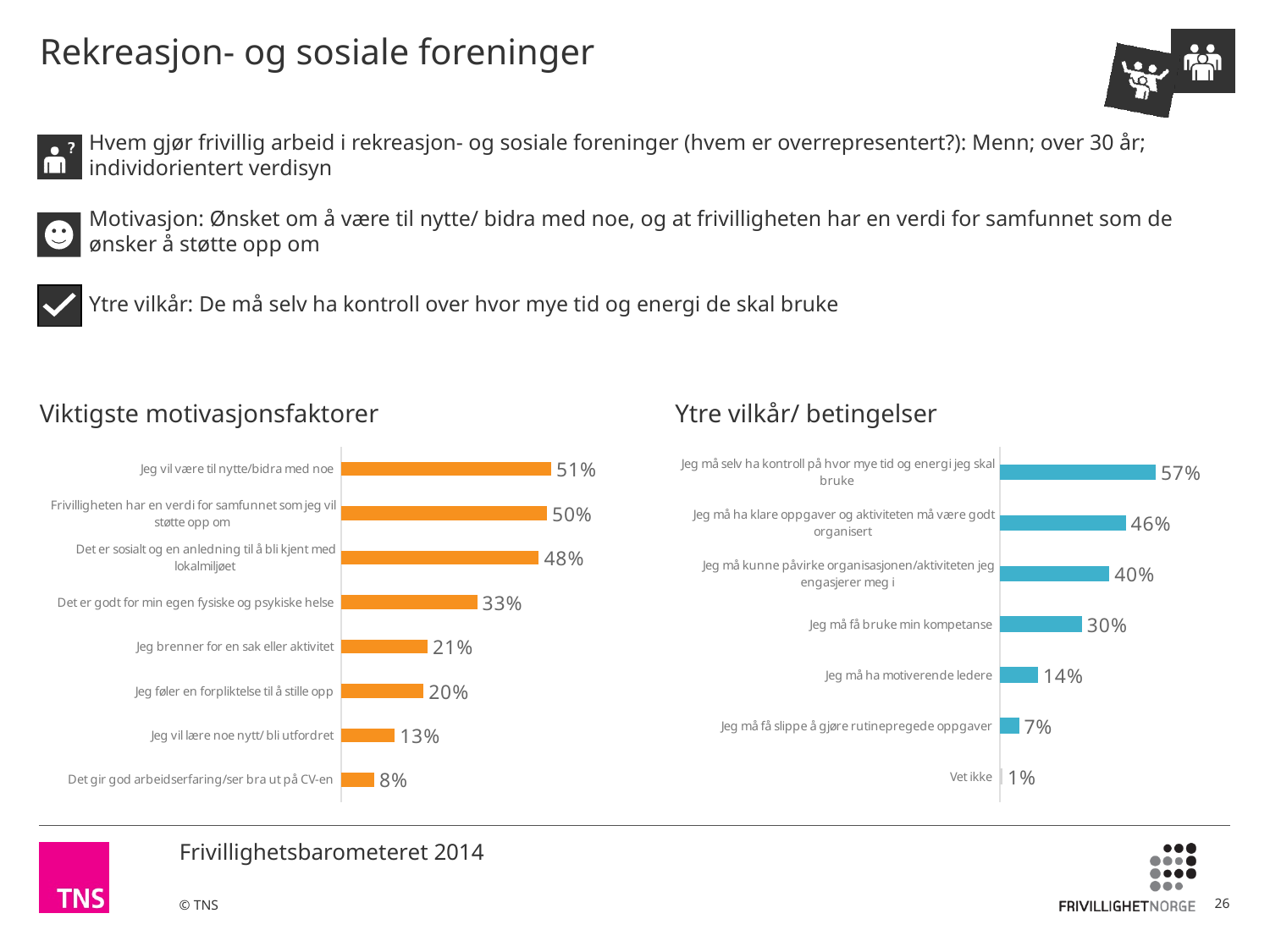
In the 'Viktigste motivasjonsfaktorer' chart, what is the difference between 'Det er godt for min egen fysiske og psykiske helse' and 'Jeg brenner for en sak eller aktivitet'? 12% In the 'Ytre vilkår/ betingelser' chart, what is the value for 'Jeg må få bruke min kompetanse'? 30% In the 'Viktigste motivasjonsfaktorer' chart, which category has the lowest value? Det gir god arbeidserfaring/ser bra ut på CV-en In the 'Ytre vilkår/ betingelser' chart, what is the difference between 'Jeg må ha klare oppgaver og aktiviteten må være godt organisert' and 'Jeg må ha motiverende ledere'? 32% In the 'Ytre vilkår/ betingelser' chart, what is the value for 'Vet ikke'? 1% In the 'Viktigste motivasjonsfaktorer' chart, what is the value for 'Jeg vil være til nytte/bidra med noe'? 51% What colour are the bars in the 'Viktigste motivasjonsfaktorer' chart? Orange What kind of chart is the 'Ytre vilkår/ betingelser' chart? Bar chart In the 'Ytre vilkår/ betingelser' chart, which category has the highest value? Jeg må selv ha kontroll på hvor mye tid og energi jeg skal bruke In the 'Viktigste motivasjonsfaktorer' chart, which is larger: 'Jeg føler en forpliktelse til å stille opp' or 'Jeg vil lære noe nytt/ bli utfordret'? Jeg føler en forpliktelse til å stille opp How many categories are shown in the 'Viktigste motivasjonsfaktorer' chart? 8 How many categories are shown in the 'Ytre vilkår/ betingelser' chart? 7